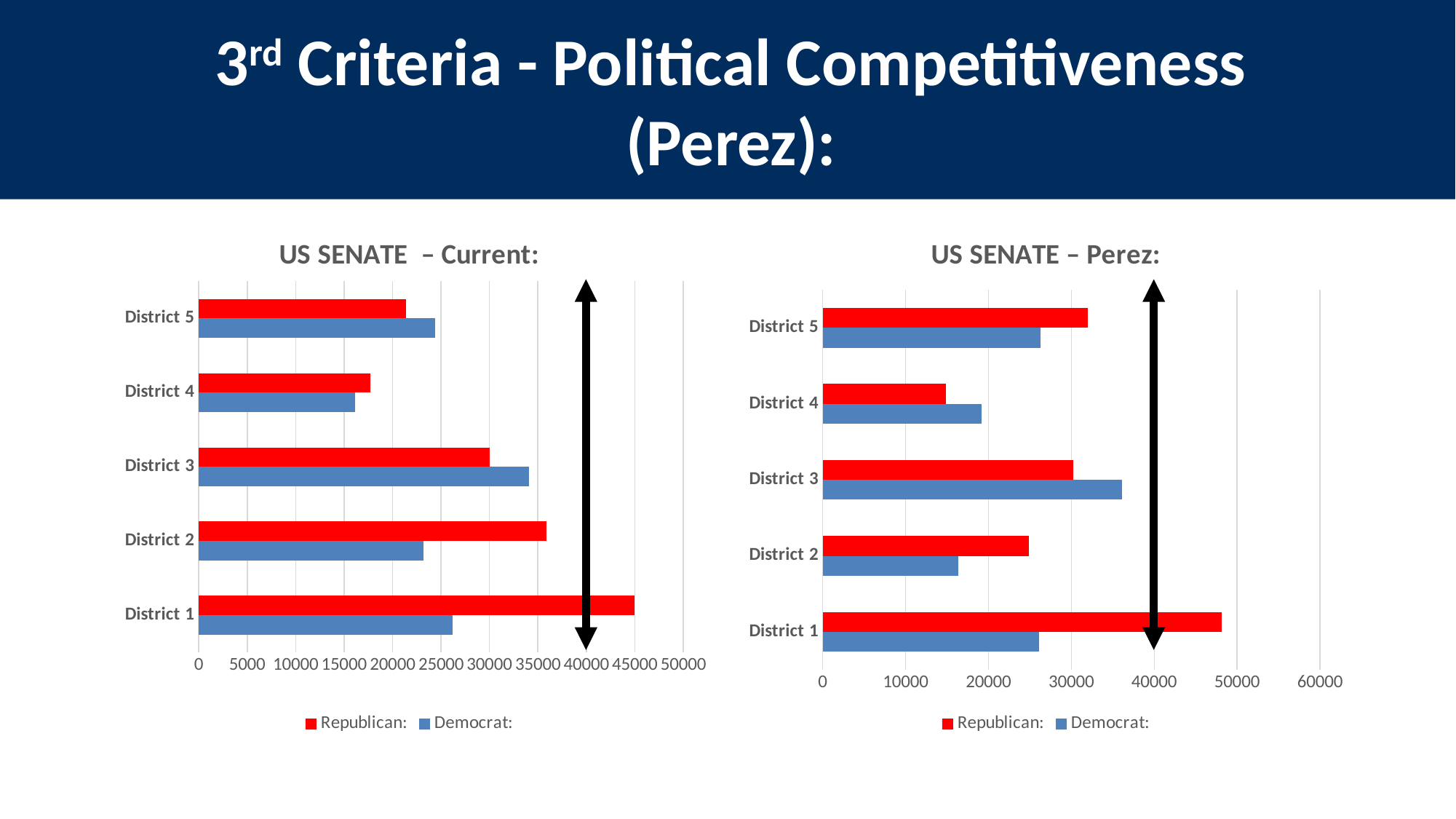
How many districts are shown on the 'US SENATE – Current:' chart? 5 On the 'US SENATE – Perez:' chart, which district has the highest Democrat value? District 3 On the 'US SENATE – Perez:' chart, which district has the lowest Republican value? District 4 On the 'US SENATE – Current:' chart, which is larger for District 2, the Republican or the Democrat value? Republican On the 'US SENATE – Current:' chart, is the Democrat value for District 4 greater or less than 20000? less On the 'US SENATE – Perez:' chart, is the Republican value for District 1 greater or less than 40000? greater On the 'US SENATE – Current:' chart, which district has the highest Republican value? District 1 How many series does the legend of the 'US SENATE – Perez:' chart list? 2 On the 'US SENATE – Perez:' chart, which is larger for District 5, the Republican or the Democrat value? Republican On the 'US SENATE – Current:' chart, is the Republican value for District 1 greater or less than 40000? greater On the 'US SENATE – Perez:' chart, what colour represents the Republican series? Red What kind of chart is the 'US SENATE – Current:' chart? Bar chart